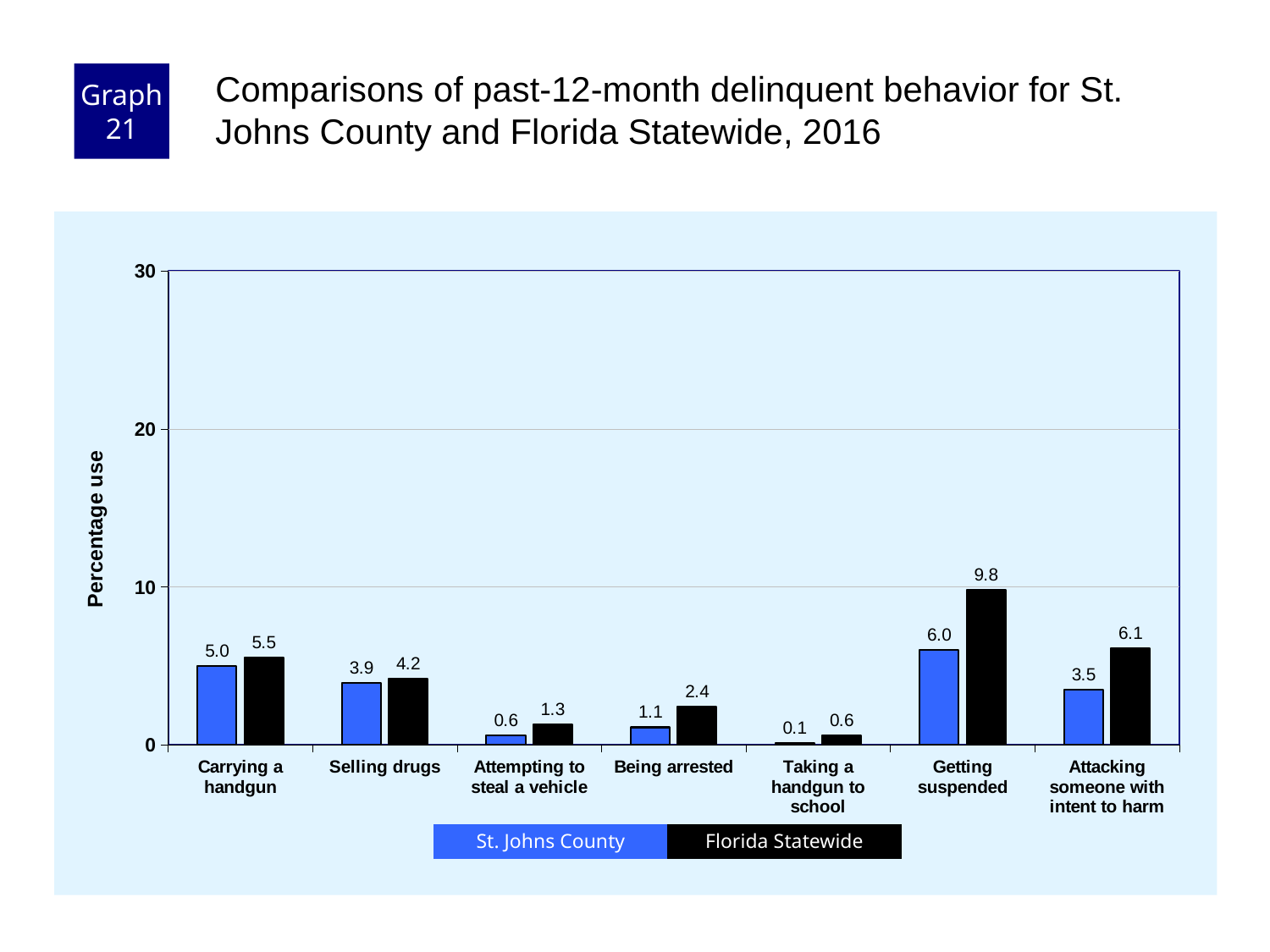
What is the Florida Statewide value for Being arrested? 2.4 What is the St. Johns County value for Getting suspended? 6.0 Which category has the highest Florida Statewide value? Getting suspended What is the difference between the Florida Statewide and St. Johns County values for Getting suspended? 3.8 What is the label of the y axis? Percentage use Which is larger for Attacking someone with intent to harm: St. Johns County or Florida Statewide? Florida Statewide Is the Florida Statewide value for Getting suspended greater or less than 10? less How many categories are shown on the x axis? 7 How many series does the legend list? 2 What kind of chart is shown? bar chart What is the St. Johns County value for Taking a handgun to school? 0.1 Which category has the lowest St. Johns County value? Taking a handgun to school